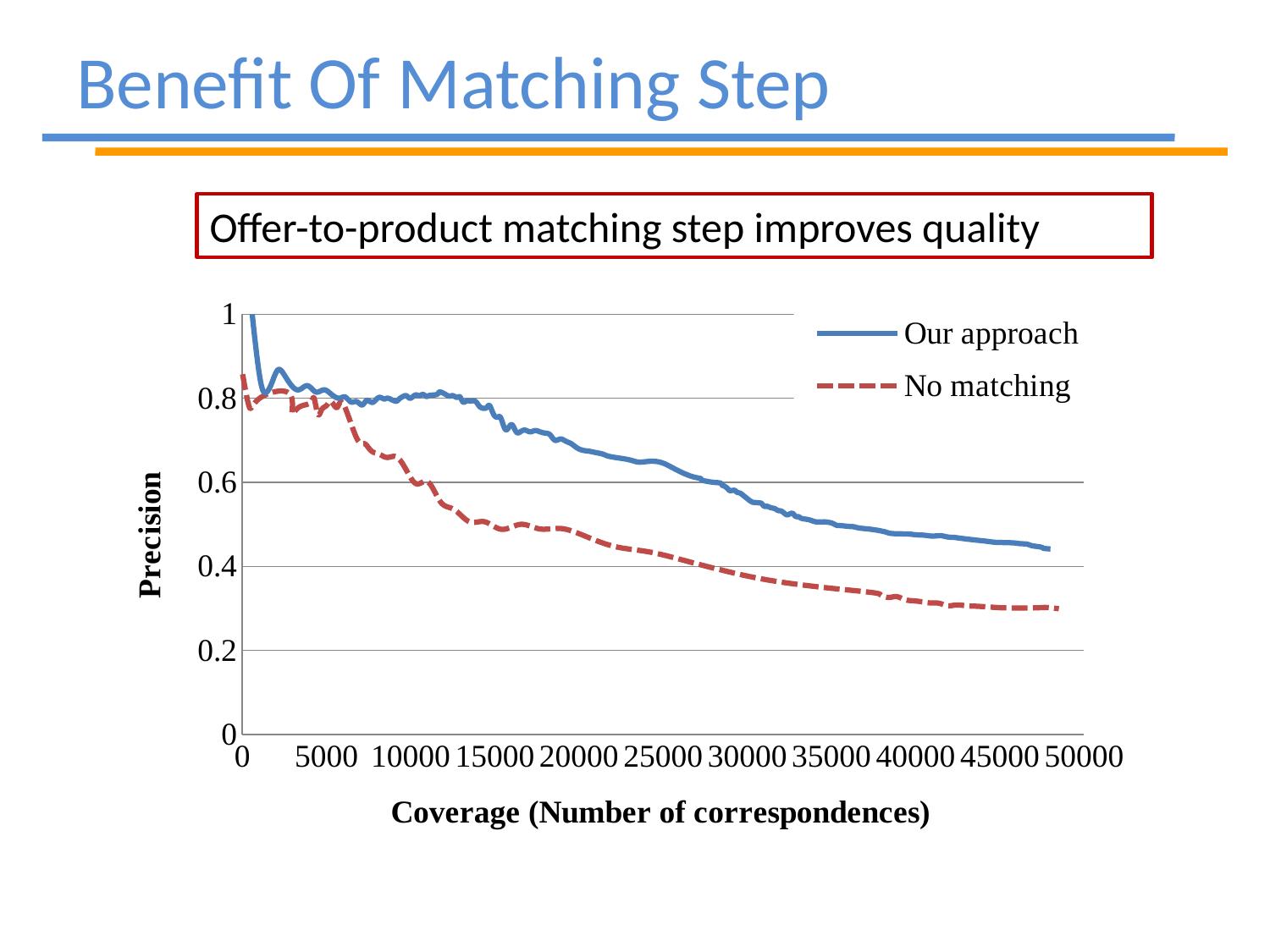
Is the precision of "No matching" at a coverage of 20000 greater or less than 0.4? greater Does the precision of "Our approach" rise or fall as coverage increases from 10000 to 50000? fall At a coverage of 30000, which series has the higher precision, "Our approach" or "No matching"? Our approach Is the precision of "No matching" at a coverage of 40000 greater or less than 0.4? less How many series does the legend list? 2 Is the precision of "Our approach" at a coverage of 20000 greater or less than 0.6? greater At a coverage of 15000, which series has the higher precision, "Our approach" or "No matching"? Our approach What kind of chart is shown on the slide? line chart What is the title of the x axis? Coverage (Number of correspondences) Does the precision of "No matching" rise or fall as coverage increases from 5000 to 50000? fall Which series is plotted with a dashed line? No matching